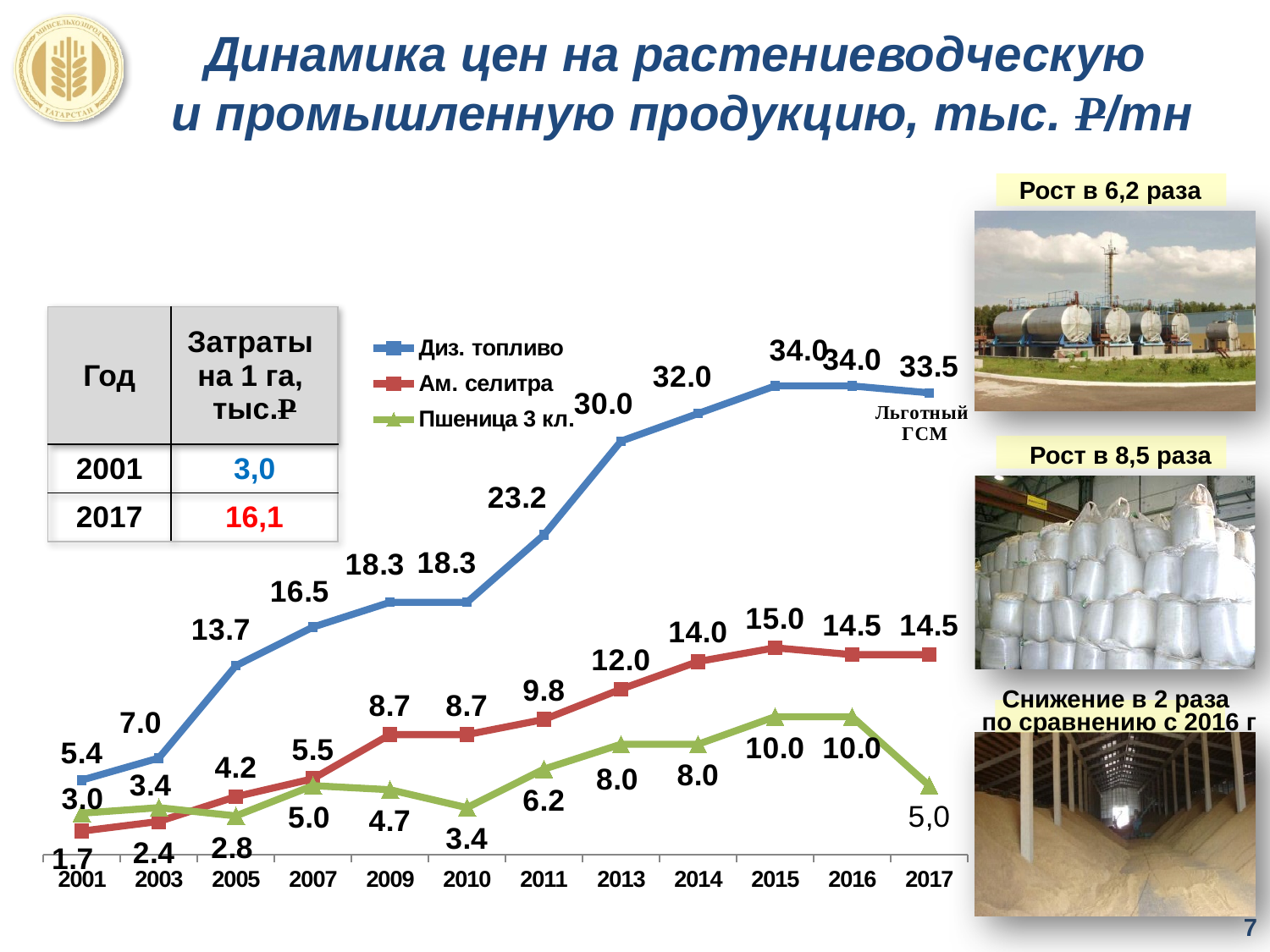
What type of chart is shown on the slide? line chart What is the value for Ам. селитра in 2013? 12.0 Which series has the larger value in 2009, Ам. селитра or Пшеница 3 кл.? Ам. селитра How many years are plotted along the x axis of the chart? 12 What is the value for Пшеница 3 кл. in 2010? 3.4 What is the value for Диз. топливо in 2015? 34.0 Which colour is used for the Пшеница 3 кл. series? green In which year is the Диз. топливо series at its lowest? 2001 Does the Диз. топливо series generally rise or fall from 2001 to 2015? rise What is the difference between the Диз. топливо values in 2017 and 2001? 28.1 In which year is the Ам. селитра series at its highest? 2015 How many series does the chart legend list? 3